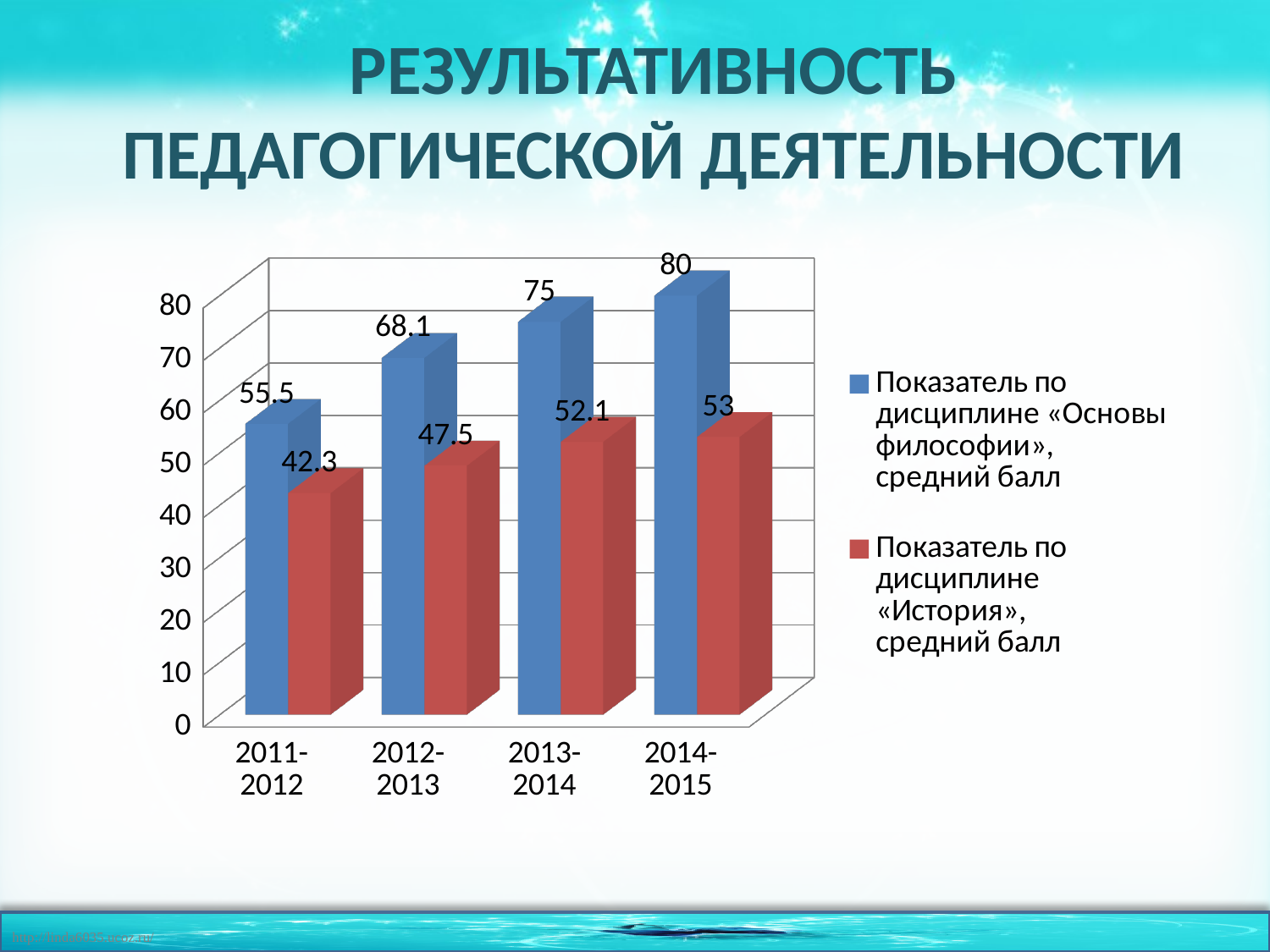
What is the value for «История» in 2013-2014? 52.1 Which is larger in 2012-2013: the value for «Основы философии» or for «История»? «Основы философии» Do the values for «История» rise or fall from 2011-2012 to 2014-2015? rise What is the value for «История» in 2012-2013? 47.5 How many year categories are shown on the x axis? 4 What is the value for «Основы философии» in 2011-2012? 55.5 In which year is the value for «История» lowest? 2011-2012 What is the value for «Основы философии» in 2014-2015? 80 What kind of chart is shown on the slide? bar chart What is the difference between the «Основы философии» and «История» values in 2014-2015? 27 In which year is the value for «Основы философии» highest? 2014-2015 How many series does the legend list? 2